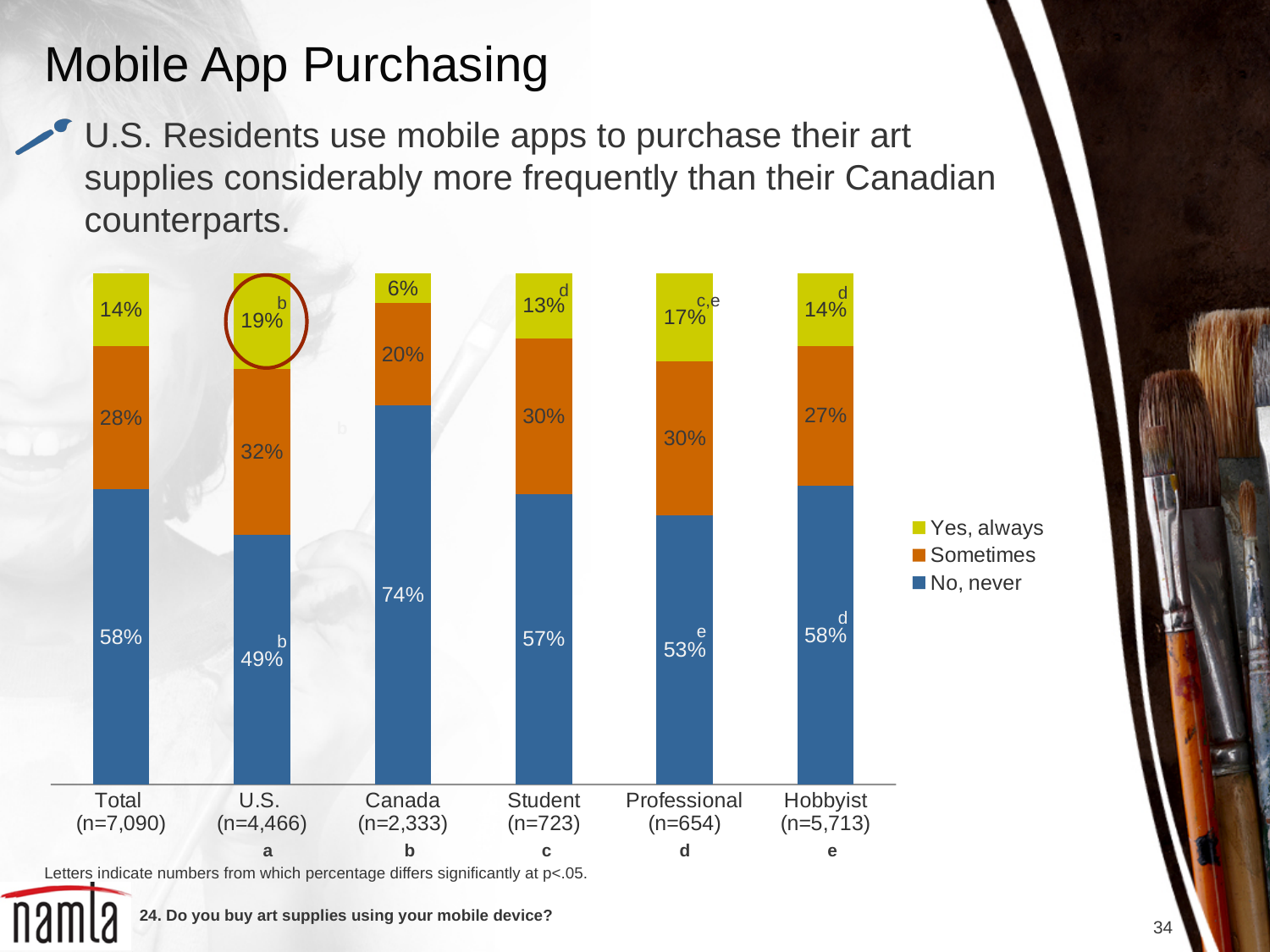
Which category has the lowest "Yes, always" percentage? Canada Which category has the highest "No, never" percentage? Canada What is the difference between the "No, never" percentages for Canada and U.S.? 25% Which has a larger "Sometimes" percentage, U.S. or Hobbyist? U.S. What is the total of the stacked bar for Student? 100% What is the sample size (n) shown for Hobbyist? n=5,713 What percentage of U.S. respondents answered "Yes, always"? 19% What kind of chart is shown on the slide? Stacked bar chart How many series does the legend list? 3 How many categories are shown on the x axis? 6 What is the "Sometimes" value for Professional? 30% What percentage of Canada respondents answered "No, never"? 74%